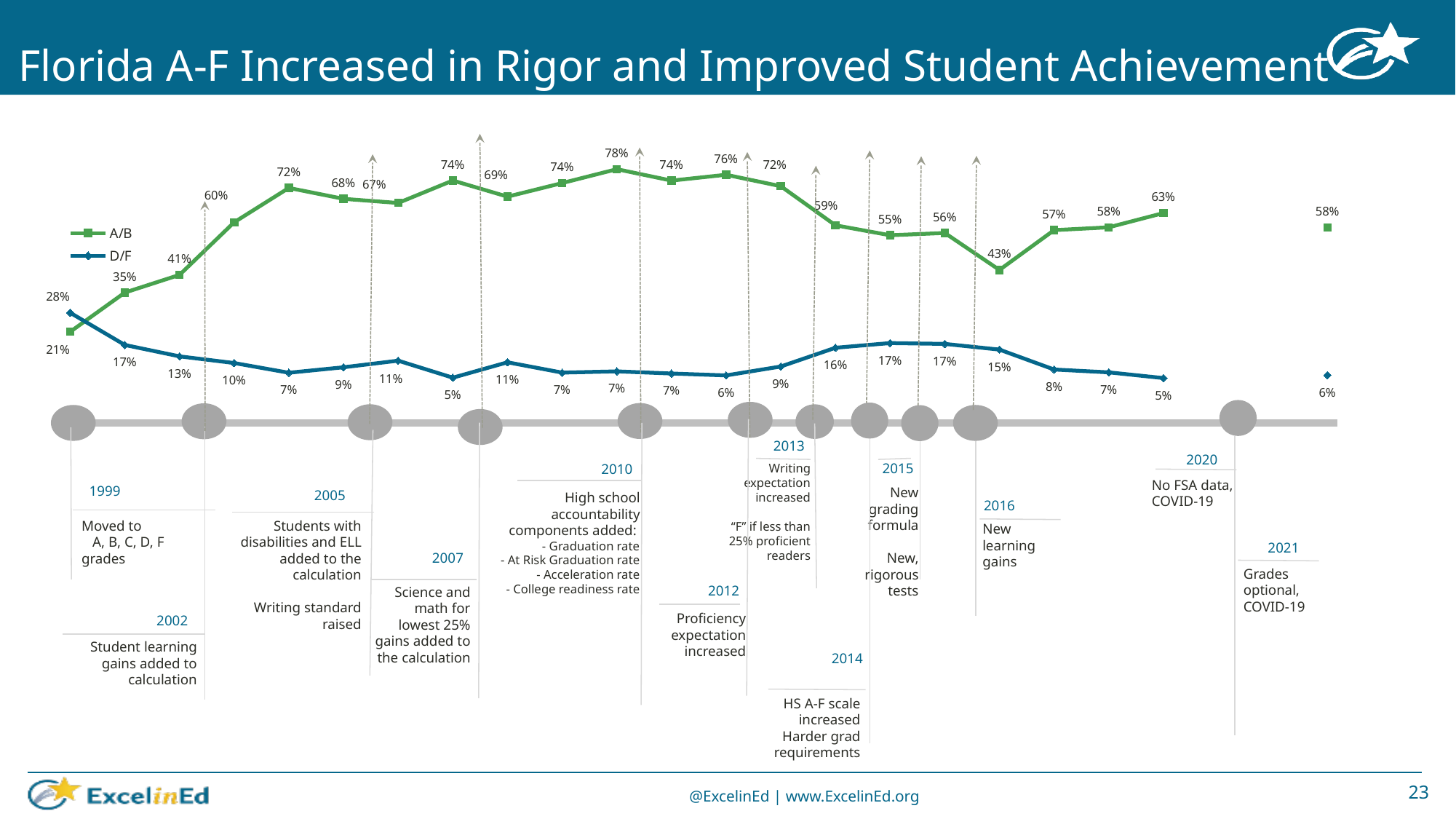
What is the highest value shown on the D/F line? 28% What kind of chart is shown on the slide? line chart What is the difference between the A/B value and the D/F value at the first data point on the left? 7 percentage points What are the two series named in the chart legend? A/B and D/F What is the lowest value shown on the D/F line? 5% How many series does the chart legend list? 2 At the first data point on the left, which series has the larger value, A/B or D/F? D/F What is the highest value shown on the A/B line? 78% What is the lowest value shown on the A/B line? 21% What is the difference between the last connected A/B value (63%) and the last connected D/F value (5%)? 58 percentage points Overall, does the A/B line rise or fall from the left of the chart to the right? rise What colour is the A/B line in the chart? green